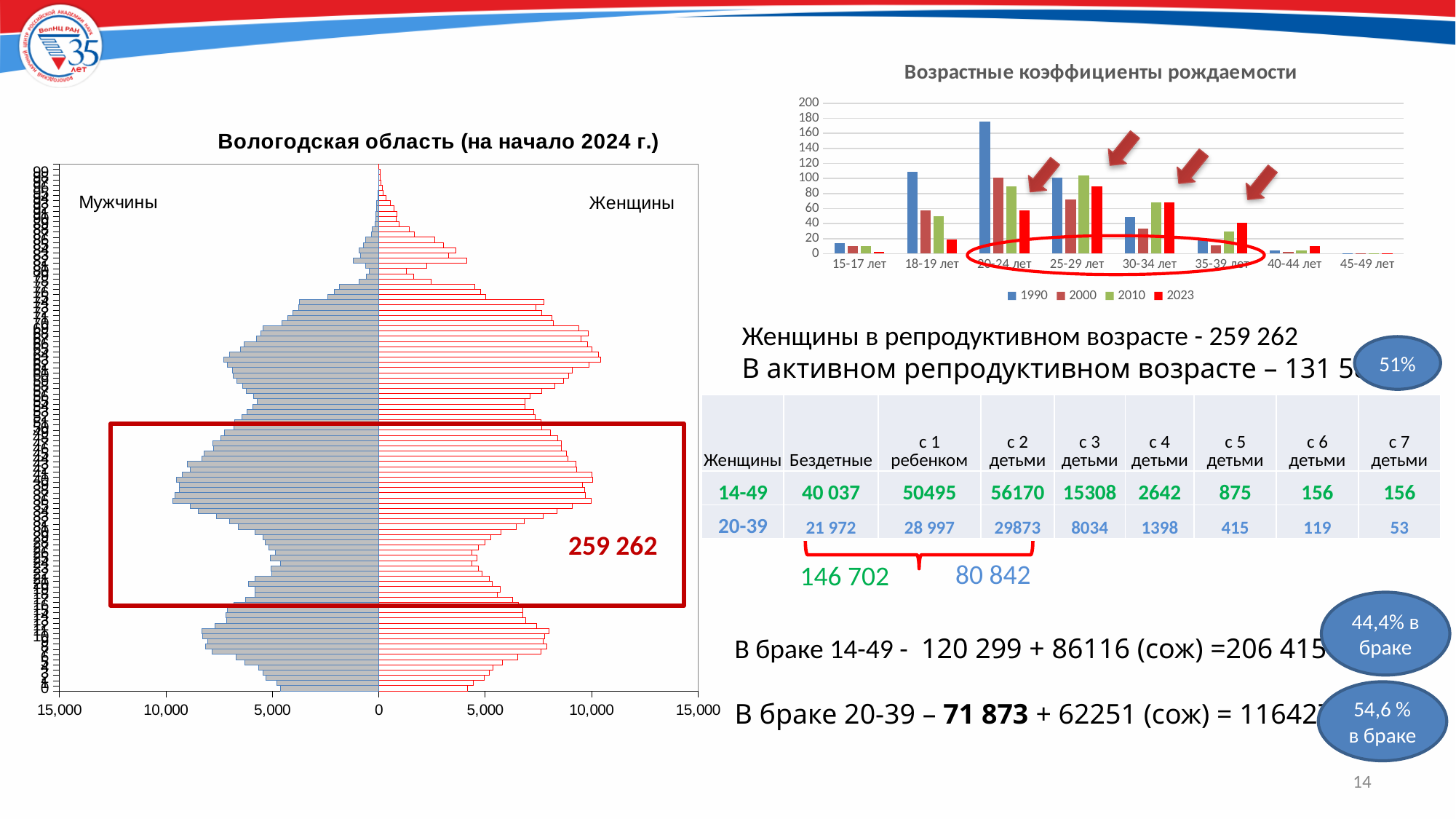
In the chart 'Возрастные коэффициенты рождаемости', how many series does the legend list? 4 In the chart 'Возрастные коэффициенты рождаемости', is the 2023 value for 35-39 лет greater or less than 20? greater In the chart 'Возрастные коэффициенты рождаемости', which age group has the highest value for the 1990 series? 20-24 лет In the chart 'Возрастные коэффициенты рождаемости', is the 2023 value for 20-24 лет greater or less than 80? less In the chart 'Возрастные коэффициенты рождаемости', which is larger for 35-39 лет: the 1990 value or the 2023 value? 2023 What kind of chart is 'Возрастные коэффициенты рождаемости'? bar chart In the chart 'Возрастные коэффициенты рождаемости', is the 1990 value for 20-24 лет greater or less than 160? greater What is the title of the chart on the right of the slide? Возрастные коэффициенты рождаемости In the chart 'Возрастные коэффициенты рождаемости', which is larger for 20-24 лет: the 1990 value or the 2023 value? 1990 In the chart 'Возрастные коэффициенты рождаемости', how many age-group categories are shown on the x axis? 8 What is the title of the chart on the left of the slide? Вологодская область (на начало 2024 г.) What kind of chart is 'Вологодская область (на начало 2024 г.)'? bar chart